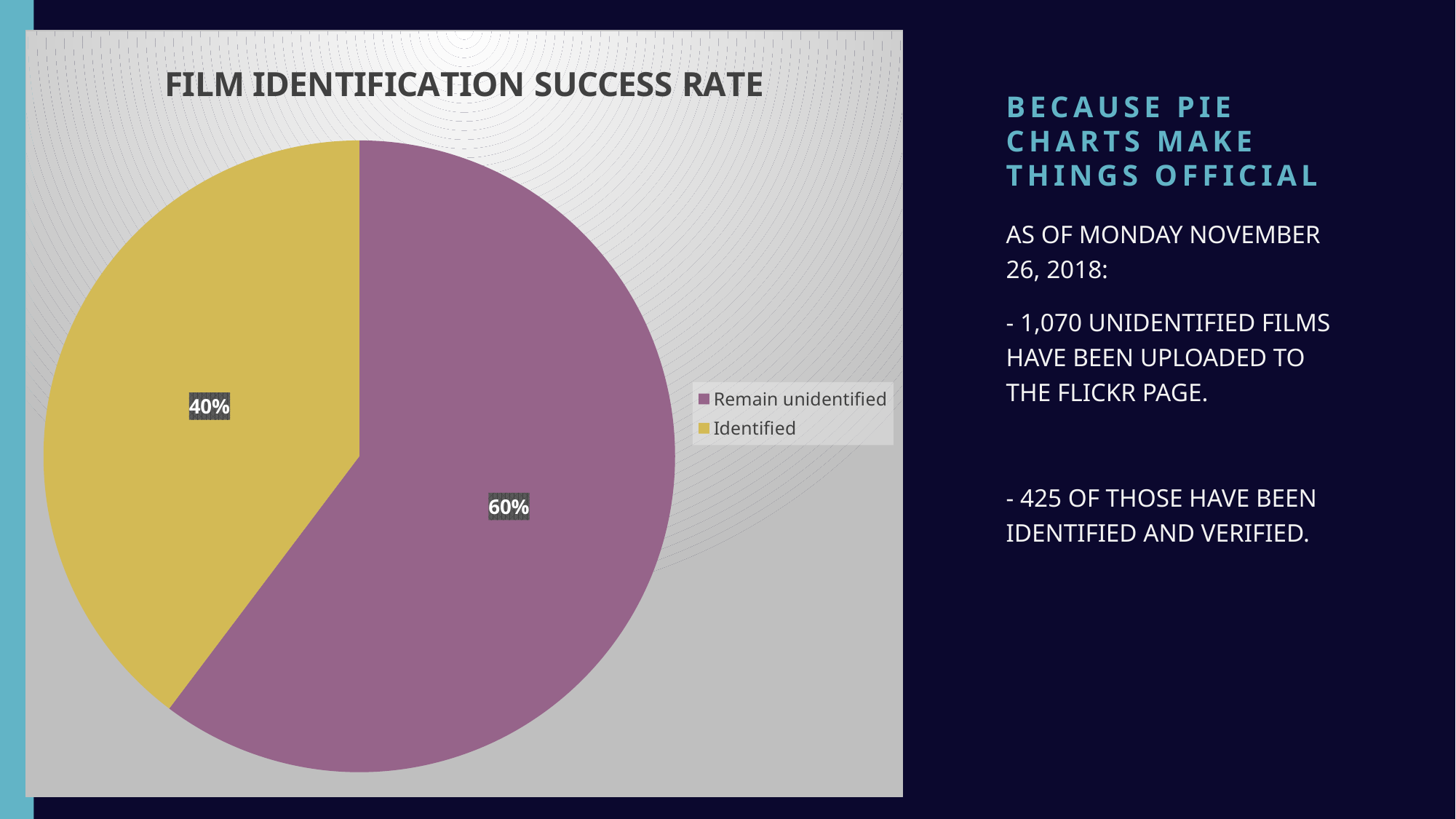
What is the difference in percentage points between the 'Remain unidentified' slice and the 'Identified' slice? 20% What colour is the 'Identified' slice? yellow What kind of chart is shown on the slide? pie chart Which is larger: the share of films that remain unidentified or the share identified? Remain unidentified What share of the pie does the 'Identified' slice represent? 40% Which slice of the pie is the smallest? Identified What is the title of the chart? FILM IDENTIFICATION SUCCESS RATE Which slice of the pie is the largest? Remain unidentified How many entries does the legend list? 2 What percentage of films have been identified according to the chart? 40% How many slices does the pie chart have? 2 What percentage of films remain unidentified according to the chart? 60%